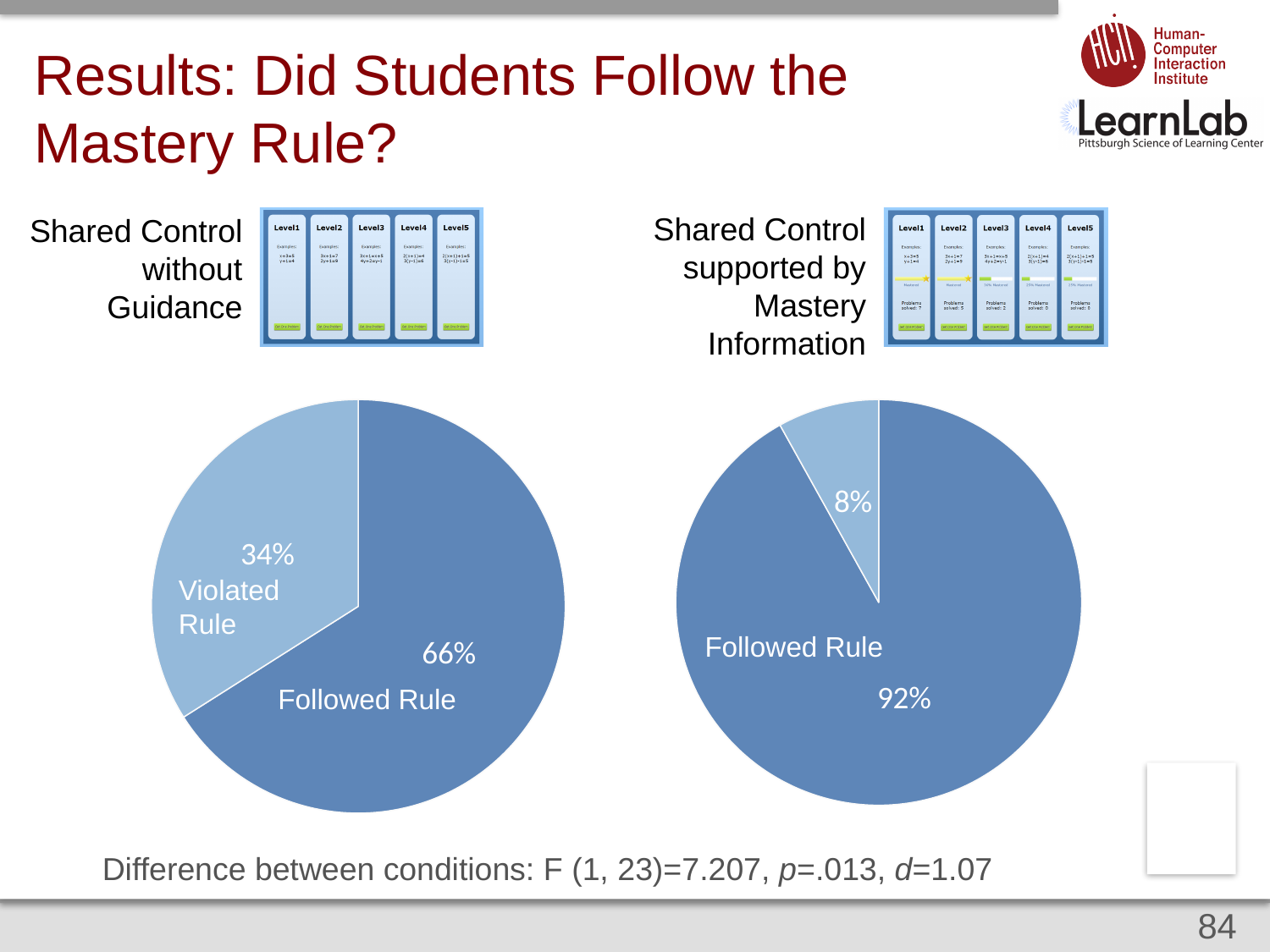
What type of chart is used on this slide to show whether students followed the mastery rule? Pie chart In the right pie chart (Shared Control supported by Mastery Information), what percentage is shown for the small slice? 8% In the left pie chart (Shared Control without Guidance), what percentage of students violated the rule? 34% In the left pie chart (Shared Control without Guidance), what percentage of students followed the rule? 66% In the left pie chart (Shared Control without Guidance), which slice is the largest? Followed Rule Which condition has the larger Followed Rule share: Shared Control without Guidance or Shared Control supported by Mastery Information? Shared Control supported by Mastery Information In the left pie chart (Shared Control without Guidance), what is the difference between the Followed Rule and Violated Rule percentages? 32% How many slices does the left pie chart (Shared Control without Guidance) have? 2 In the right pie chart (Shared Control supported by Mastery Information), what percentage of students followed the rule? 92% In the right pie chart (Shared Control supported by Mastery Information), which slice is the smallest? The 8% slice What is the difference in the Followed Rule percentage between the right pie chart (92%) and the left pie chart (66%)? 26% What is the share of the Followed Rule slice in the left pie chart (Shared Control without Guidance)? 66%